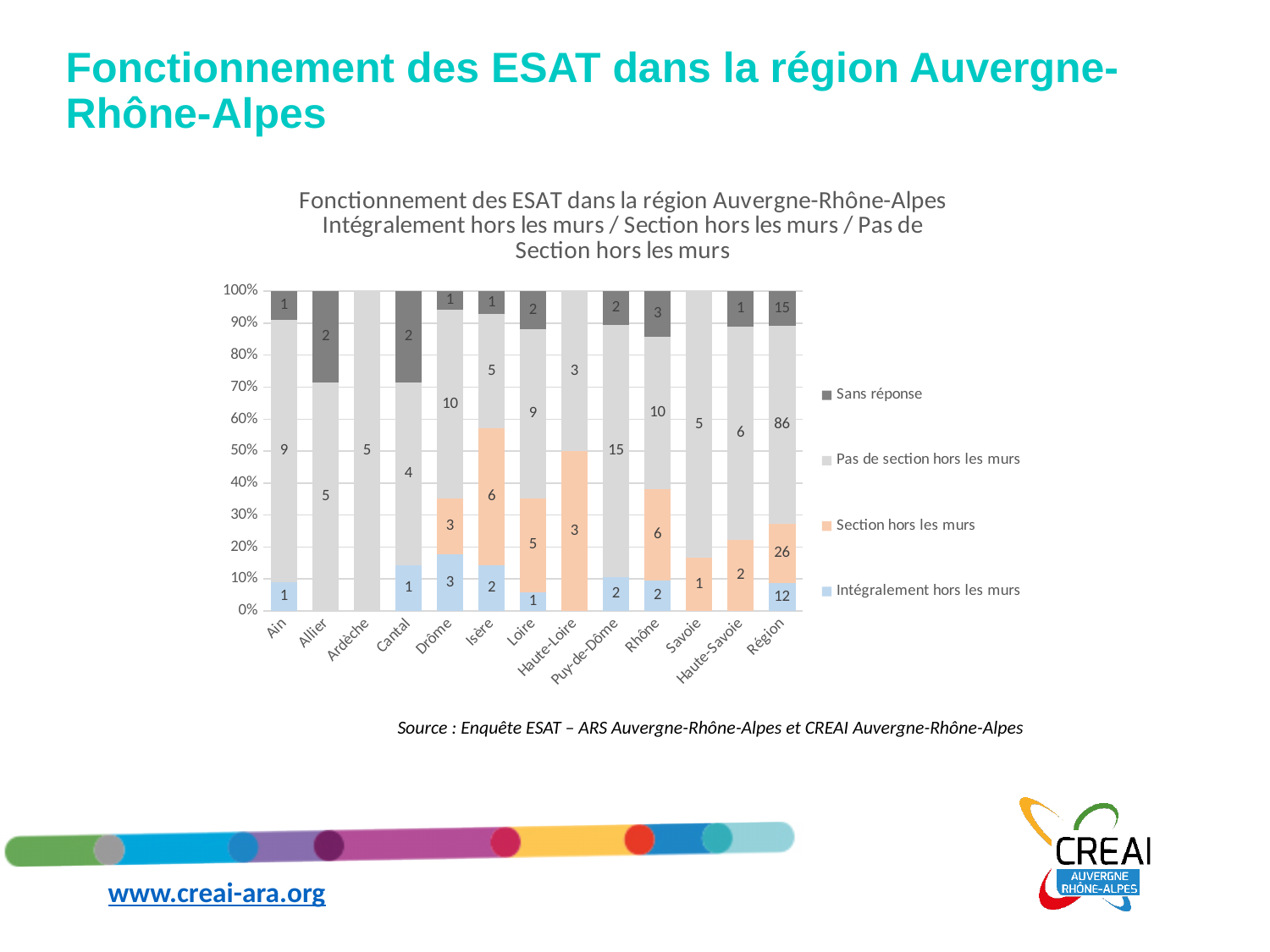
How many categories are shown along the x axis of the chart? 13 What is the total of the stacked bar for Rhône? 21 What is the difference between the 'Pas de section hors les murs' values for Puy-de-Dôme and Drôme? 5 Which is larger: the 'Section hors les murs' value for Allier or for Haute-Loire? Haute-Loire What is the value of 'Section hors les murs' for Isère? 6 What is the value of 'Intégralement hors les murs' for Drôme? 3 What is the value of 'Pas de section hors les murs' for Région? 86 What is the value of 'Sans réponse' for Rhône? 3 What is the total of the stacked bar for Région? 139 What kind of chart is shown on the slide? Stacked bar chart How many series does the chart legend list? 4 Which category has the highest 'Pas de section hors les murs' value? Région